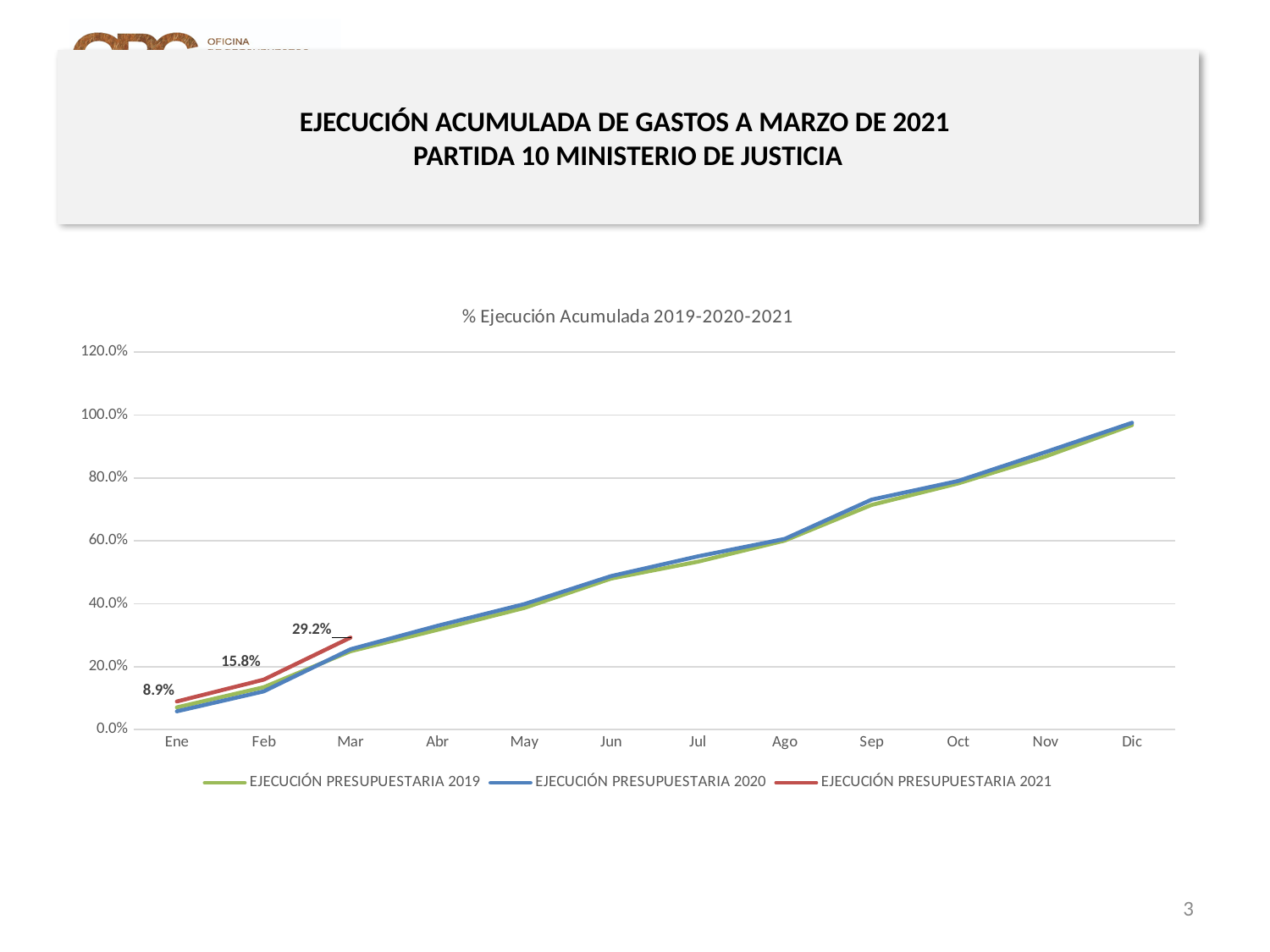
Is the value for EJECUCIÓN PRESUPUESTARIA 2020 in Dic greater or less than 80.0%? greater What is the value of EJECUCIÓN PRESUPUESTARIA 2021 for Mar? 29.2% How many series does the legend list? 3 How many months are shown on the x axis? 12 What is the title of the chart? % Ejecución Acumulada 2019-2020-2021 What is the value of EJECUCIÓN PRESUPUESTARIA 2021 for Feb? 15.8% What is the value of EJECUCIÓN PRESUPUESTARIA 2021 for Ene? 8.9% What is the difference between the EJECUCIÓN PRESUPUESTARIA 2021 values for Ene and Mar? 20.3% Is the value for EJECUCIÓN PRESUPUESTARIA 2019 in Jun greater or less than 60.0%? less What kind of chart is shown on the slide? Line chart Do the values for EJECUCIÓN PRESUPUESTARIA 2020 rise or fall from Ene to Dic? Rise By how much did EJECUCIÓN PRESUPUESTARIA 2021 increase from Feb to Mar? 13.4%